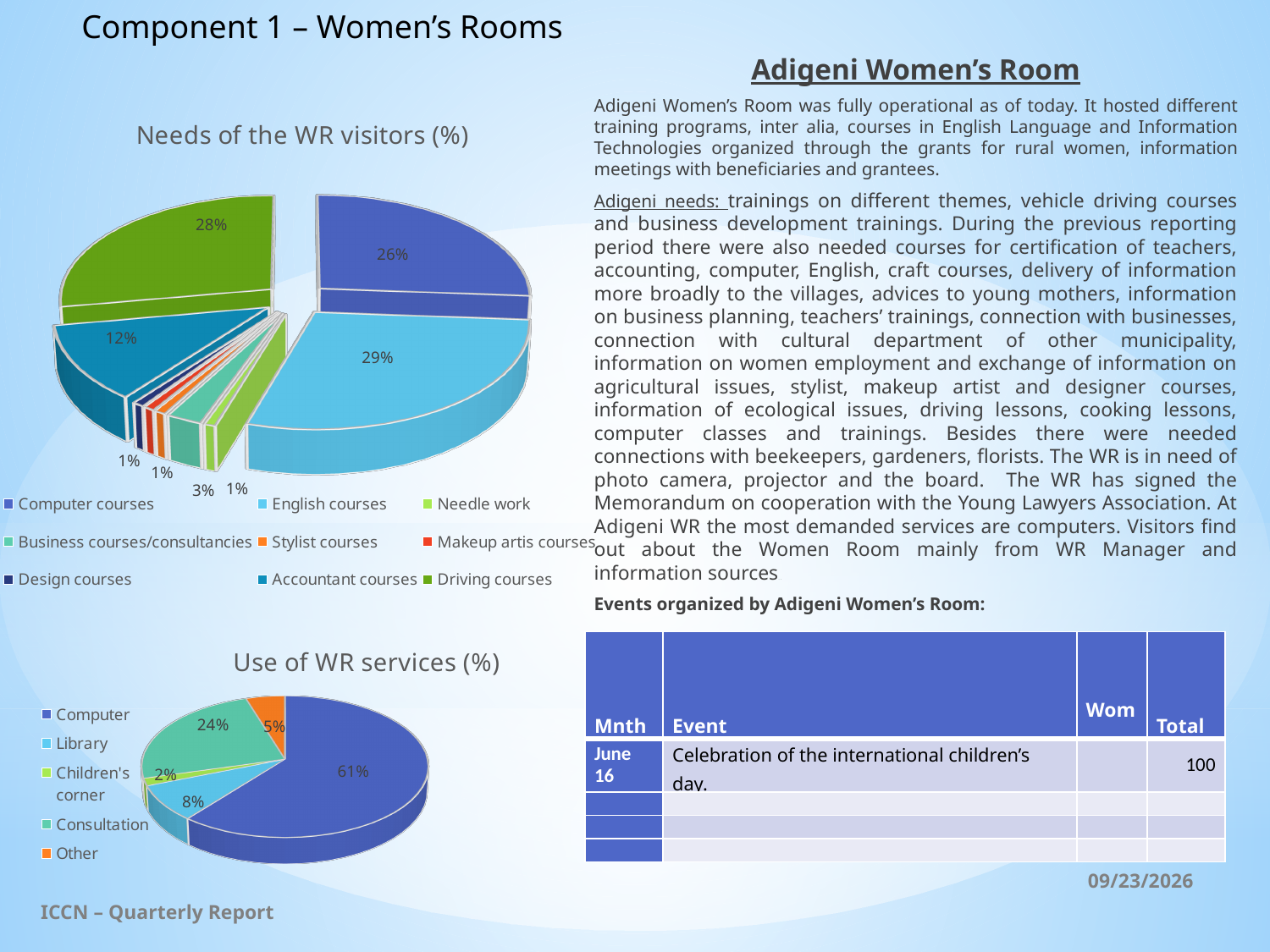
In the 'Needs of the WR visitors (%)' chart, what percentage is shown for Computer courses? 26% In the 'Use of WR services (%)' chart, what percentage is shown for Consultation? 24% In the 'Use of WR services (%)' chart, what percentage is shown for Library? 8% In the 'Needs of the WR visitors (%)' chart, how many categories does the legend list? 9 In the 'Use of WR services (%)' chart, which service has the smallest share? Children's corner In the 'Needs of the WR visitors (%)' chart, what percentage is shown for Accountant courses? 12% In the 'Needs of the WR visitors (%)' chart, what percentage is shown for English courses? 29% In the 'Use of WR services (%)' chart, how many categories does the legend list? 5 In the 'Use of WR services (%)' chart, what is the difference between the Computer share and the Consultation share? 37% What type of chart is 'Needs of the WR visitors (%)'? Pie chart In the 'Needs of the WR visitors (%)' chart, which is larger, the share for Driving courses or the share for Computer courses? Driving courses In the 'Use of WR services (%)' chart, what percentage is shown for Computer? 61%